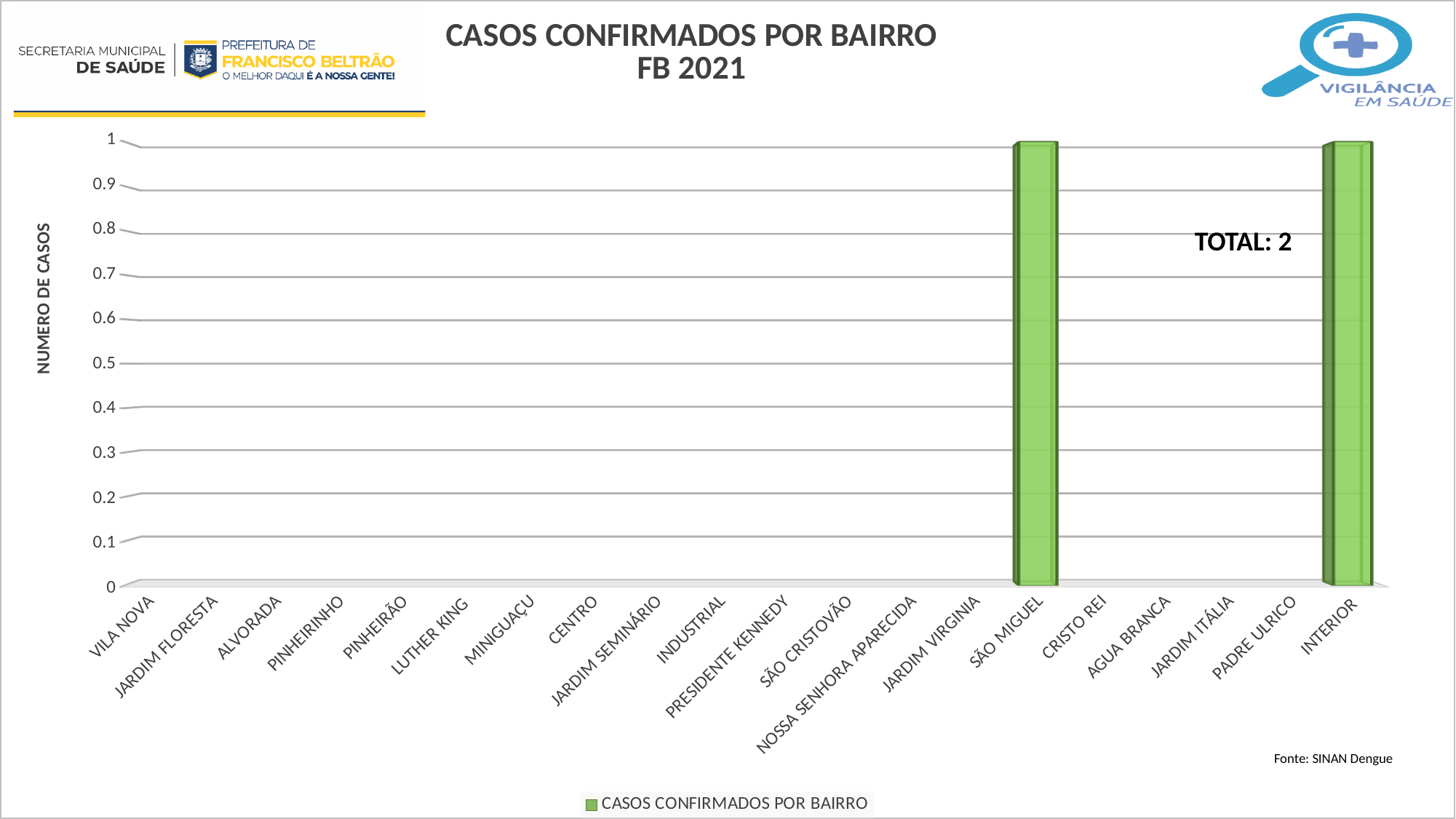
Which categories have the highest value in the chart? SÃO MIGUEL and INTERIOR What is the value for INTERIOR? 1 What type of chart is shown on the slide? Bar chart What is the title of the chart? CASOS CONFIRMADOS POR BAIRRO FB 2021 What total is printed on the chart? TOTAL: 2 What is the value for SÃO MIGUEL? 1 How many series does the legend list? 1 How many categories (bairros) are shown on the x axis? 20 Which is larger, the value for SÃO MIGUEL or the value for VILA NOVA? SÃO MIGUEL How many bairros have a bar with a value greater than 0? 2 What is the value for CENTRO? 0 What is the difference between the value for INTERIOR and the value for JARDIM FLORESTA? 1